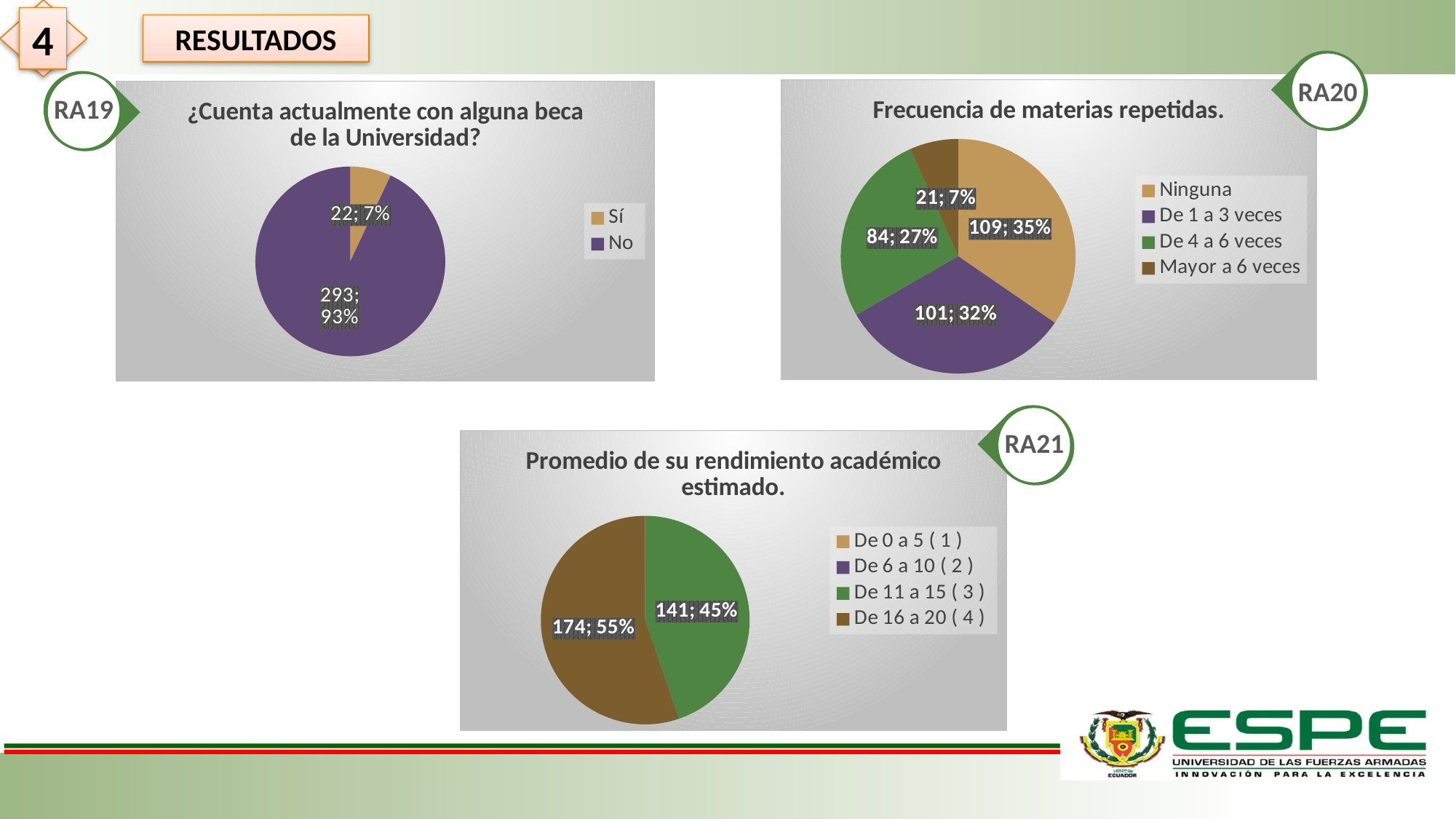
In the chart titled 'Frecuencia de materias repetidas.', which category has the highest value? Ninguna In the chart titled 'Frecuencia de materias repetidas.', which category has the lowest value? Mayor a 6 veces In the chart titled 'Promedio de su rendimiento académico estimado.', what is the value for 'De 16 a 20 ( 4 )'? 174; 55% In the chart titled '¿Cuenta actualmente con alguna beca de la Universidad?', what is the value for 'No'? 293; 93% In the chart titled '¿Cuenta actualmente con alguna beca de la Universidad?', what share of the pie does 'Sí' represent? 7% In the chart titled 'Frecuencia de materias repetidas.', what is the count for 'De 4 a 6 veces'? 84 In the chart titled 'Promedio de su rendimiento académico estimado.', how many slices are plotted in the pie? 2 What kind of chart is the one titled 'Frecuencia de materias repetidas.'? Pie chart In the chart titled 'Frecuencia de materias repetidas.', how many categories does the legend list? 4 In the chart titled 'Promedio de su rendimiento académico estimado.', which is larger: 'De 11 a 15 ( 3 )' or 'De 16 a 20 ( 4 )'? De 16 a 20 ( 4 ) In the chart titled 'Frecuencia de materias repetidas.', what is the difference between the counts for 'Ninguna' and 'De 1 a 3 veces'? 8 In the chart titled 'Promedio de su rendimiento académico estimado.', what colour is the slice for 'De 11 a 15 ( 3 )'? Green